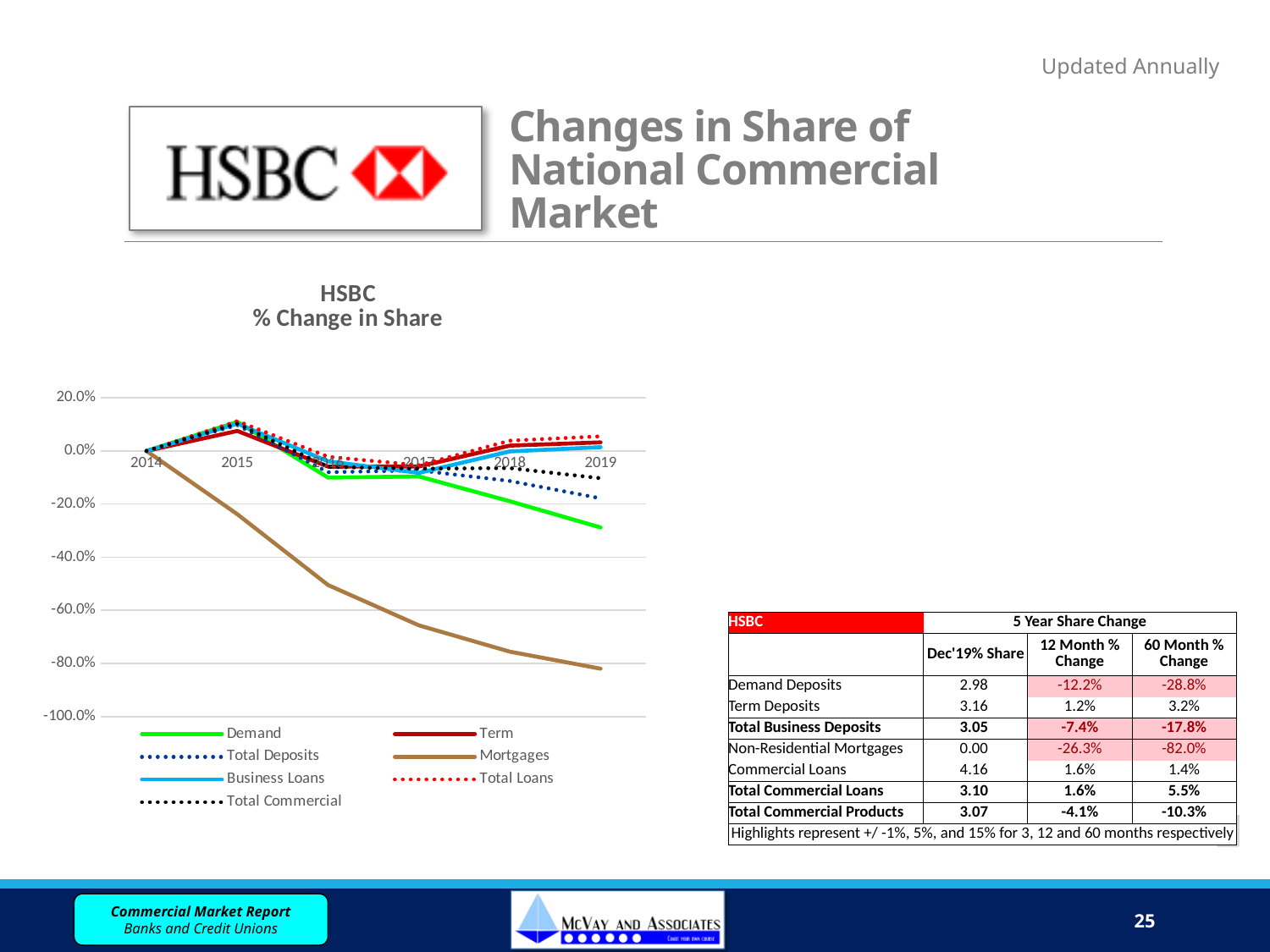
How many years are plotted along the x axis of the chart? 6 Does the Mortgages line rise or fall from 2014 to 2019? fall Is the value for Total Commercial in 2019 greater or less than -20.0%? greater What is the title of the chart? HSBC % Change in Share Is the value for Demand in 2019 greater or less than -40.0%? greater Is the value for Mortgages in 2017 greater or less than -60.0%? less Which series has the lowest value in 2019? Mortgages What kind of chart is shown on the slide? line chart In 2019, which is larger, the value for Demand or the value for Mortgages? Demand Which series is drawn as a solid green line? Demand How many series does the chart legend list? 7